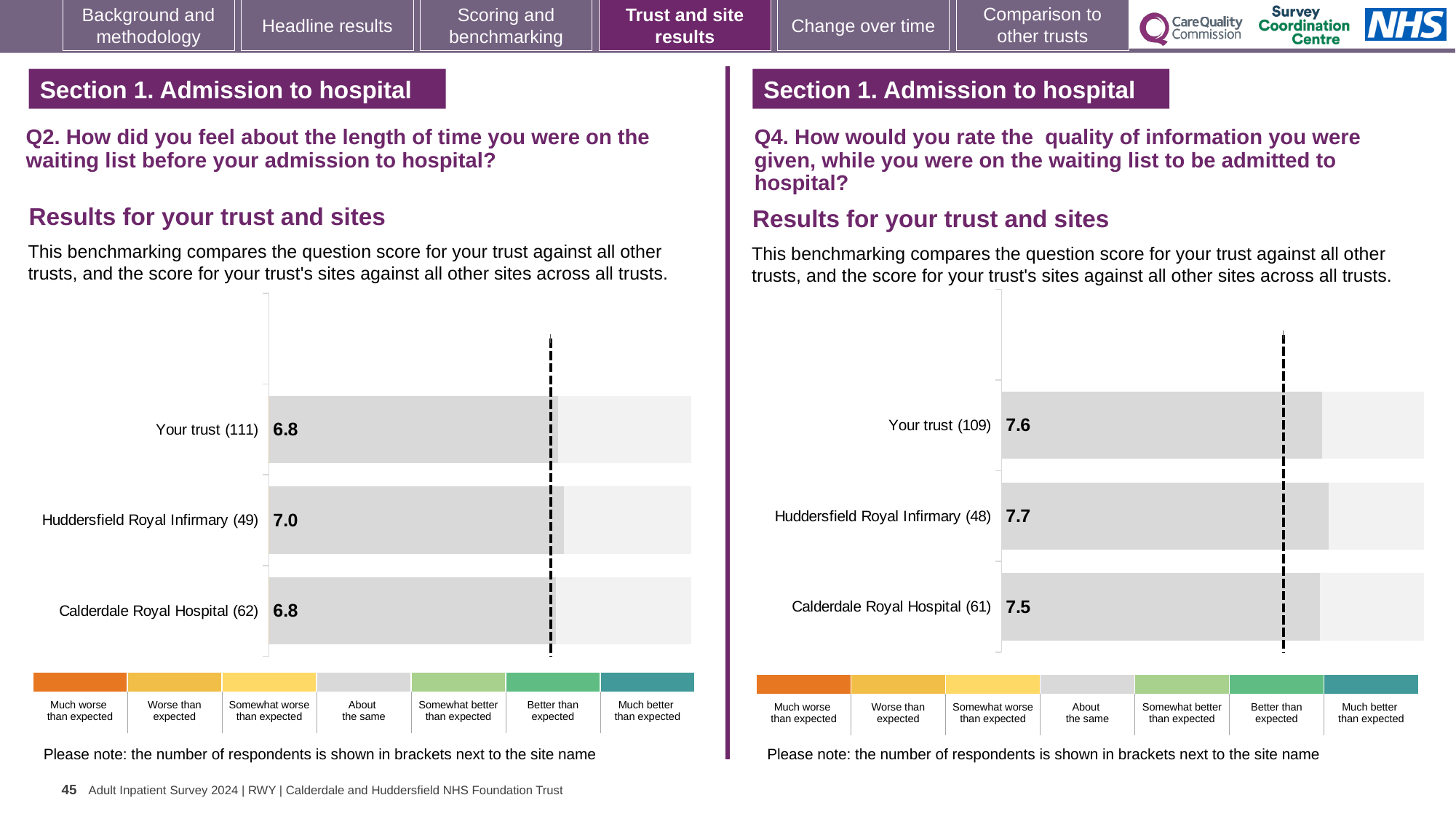
In the Q4 chart on the right, which has the larger score, Your trust or Huddersfield Royal Infirmary? Huddersfield Royal Infirmary In the Q4 chart on the right, what is the score for Calderdale Royal Hospital? 7.5 In the Q2 chart on the left, what is the score for Your trust? 6.8 In the Q2 chart on the left, what is the score for Huddersfield Royal Infirmary? 7.0 In the Q2 chart on the left, what is the difference between the scores for Huddersfield Royal Infirmary and Your trust? 0.2 In the Q4 chart on the right, how many respondents are shown in brackets for Huddersfield Royal Infirmary? 48 In the Q2 chart on the left, which site or trust has the highest score? Huddersfield Royal Infirmary How many bars are plotted in the Q2 chart on the left? 3 In the Q4 chart on the right, what is the score for Your trust? 7.6 What type of chart is used for the Q4 results on the right? Bar chart In the Q4 chart on the right, what is the difference between the scores for Huddersfield Royal Infirmary and Calderdale Royal Hospital? 0.2 In the Q4 chart on the right, which site or trust has the lowest score? Calderdale Royal Hospital